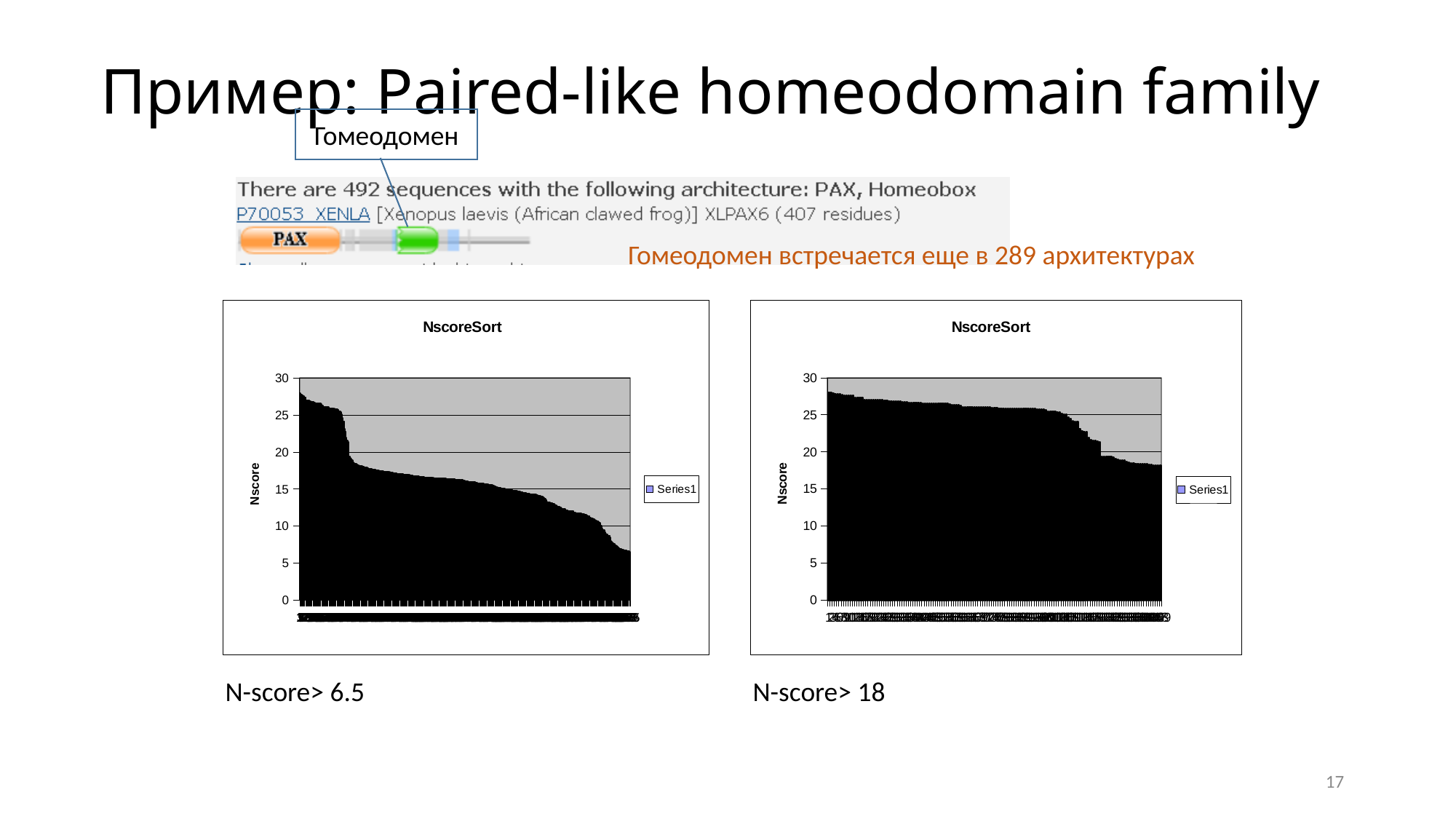
What is the label of the y axis on the right chart? Nscore What kind of chart is the right NscoreSort chart? bar chart In the right chart, do the values rise or fall along the x axis? fall What kind of chart is the left NscoreSort chart? bar chart In the left chart, do the values rise or fall along the x axis? fall What is the title of the chart on the left side of the slide? NscoreSort In the left chart, is the value of the last (rightmost) bar greater or less than 10? less What is the name of the series shown in the legend of the right chart? Series1 In the left chart, is the value of the first (leftmost) bar greater or less than 25? greater In the right chart, is the value of the first (leftmost) bar greater or less than 25? greater How many series does the legend of the left chart list? 1